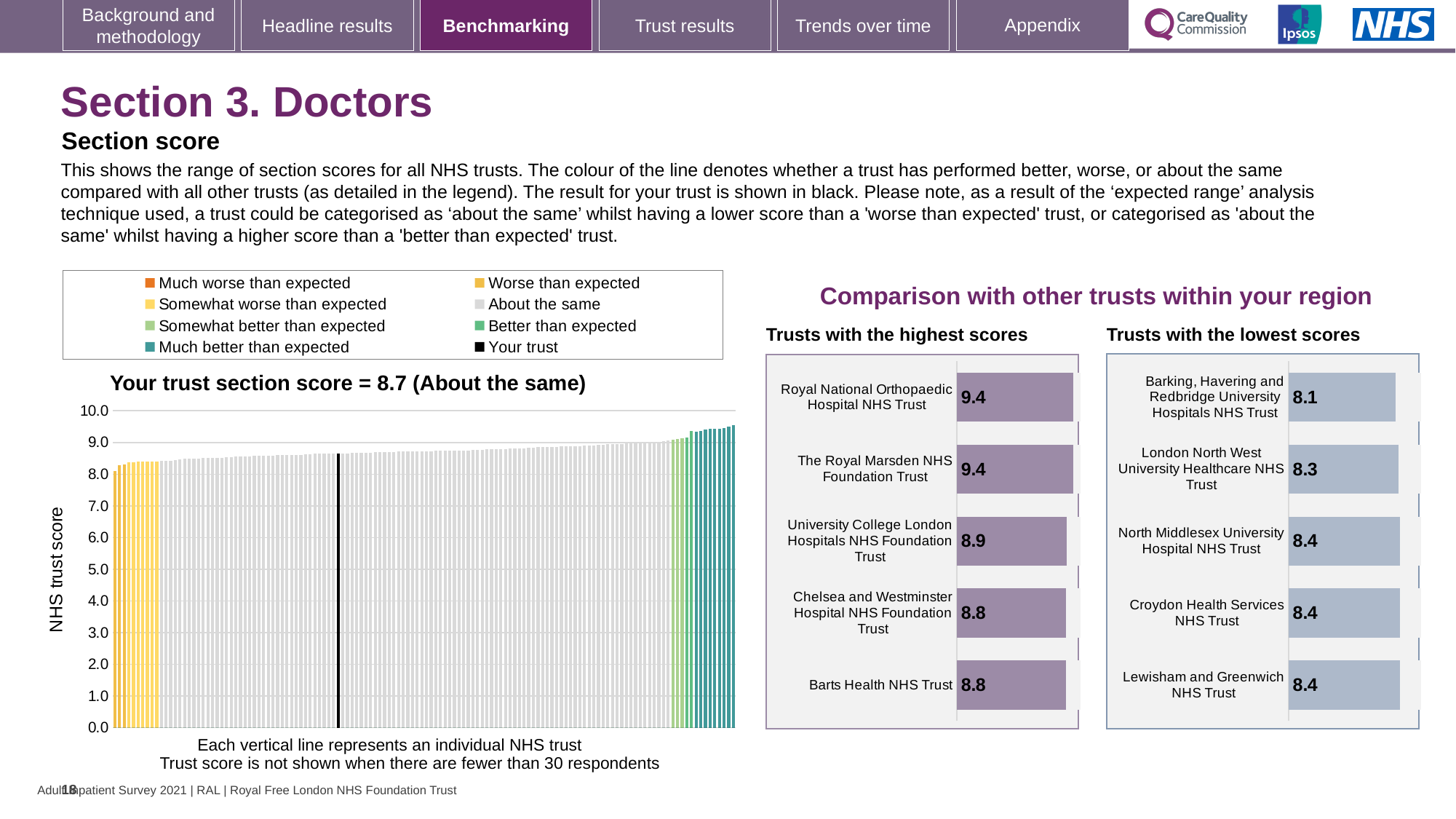
In the 'Trusts with the highest scores' chart, what is the score for Barts Health NHS Trust? 8.8 In the 'Trusts with the lowest scores' chart, what is the difference between the score for London North West University Healthcare NHS Trust and the score for Barking, Havering and Redbridge University Hospitals NHS Trust? 0.2 In the 'Trusts with the highest scores' chart, what is the difference between the score for Royal National Orthopaedic Hospital NHS Trust and the score for Barts Health NHS Trust? 0.6 In the 'Trusts with the highest scores' chart, which has the higher score: University College London Hospitals NHS Foundation Trust or Chelsea and Westminster Hospital NHS Foundation Trust? University College London Hospitals NHS Foundation Trust In the 'Trusts with the lowest scores' chart, what is the score for Barking, Havering and Redbridge University Hospitals NHS Trust? 8.1 In the 'Trusts with the highest scores' chart, what is the score for University College London Hospitals NHS Foundation Trust? 8.9 In the 'Trusts with the lowest scores' chart, which trust has the lowest score? Barking, Havering and Redbridge University Hospitals NHS Trust How many trusts are shown in the 'Trusts with the highest scores' chart? 5 According to the title of the chart on the left, what is your trust's section score? 8.7 (About the same) In the 'Trusts with the lowest scores' chart, what is the score for Croydon Health Services NHS Trust? 8.4 What kind of chart is the large chart on the left showing NHS trust scores? Bar chart How many entries does the legend above the chart on the left list? 8